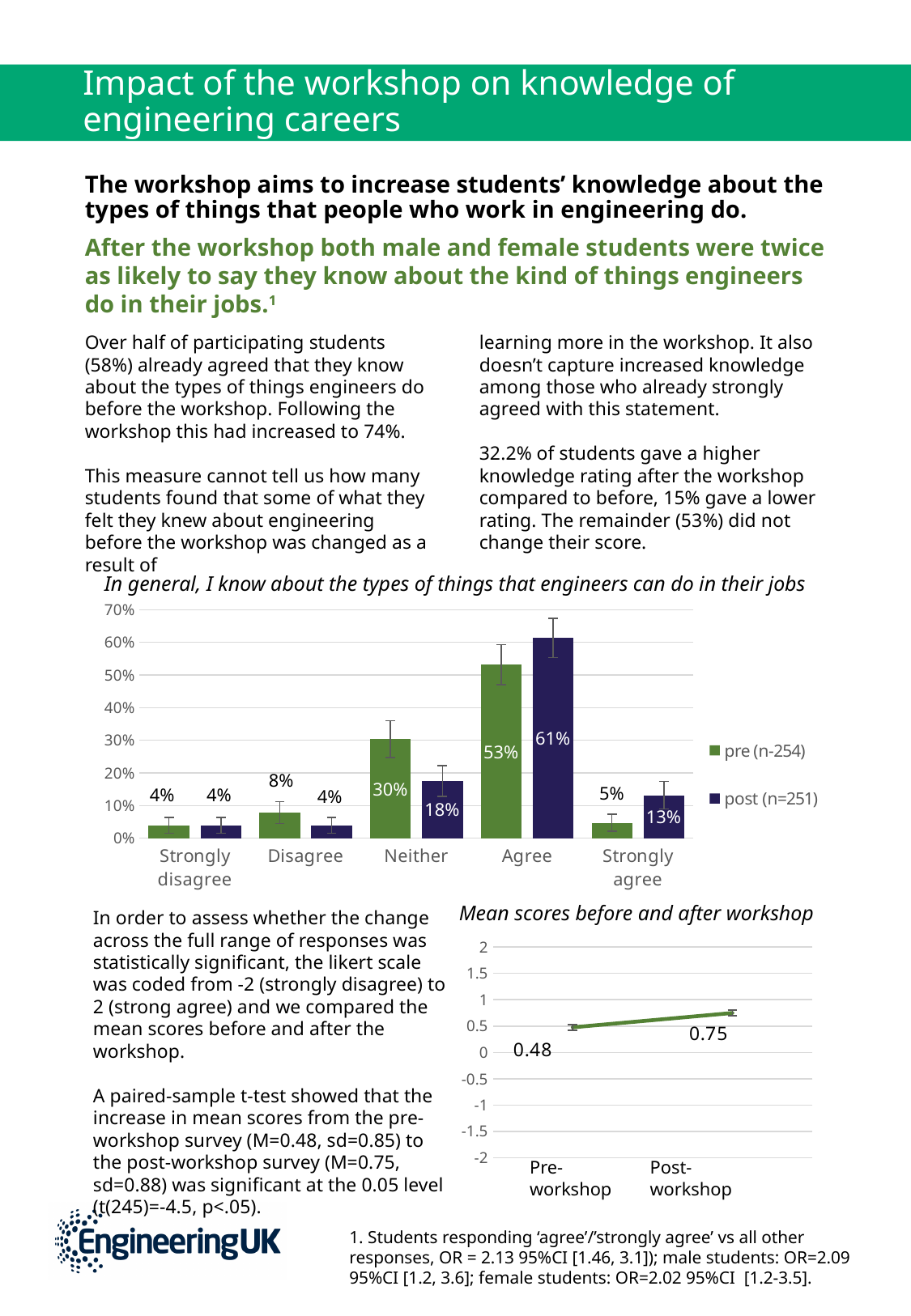
In the chart 'Mean scores before and after workshop', do the values rise or fall from Pre-workshop to Post-workshop? rise In the chart 'In general, I know about the types of things that engineers can do in their jobs', which category has the highest post-workshop value? Agree In the chart 'In general, I know about the types of things that engineers can do in their jobs', how many series does the legend list? 2 In the chart 'In general, I know about the types of things that engineers can do in their jobs', what is the difference between the post and pre values for Agree? 8% In the chart 'In general, I know about the types of things that engineers can do in their jobs', what is the pre-workshop value for Agree? 53% In the chart 'Mean scores before and after workshop', what is the difference between the Post-workshop and Pre-workshop mean scores? 0.27 In the chart 'In general, I know about the types of things that engineers can do in their jobs', which is larger for Neither: the pre value or the post value? pre In the chart 'In general, I know about the types of things that engineers can do in their jobs', how many response categories are shown on the x axis? 5 In the chart 'Mean scores before and after workshop', what is the mean score for Post-workshop? 0.75 In the chart 'In general, I know about the types of things that engineers can do in their jobs', what is the post-workshop value for Strongly agree? 13% In the chart 'In general, I know about the types of things that engineers can do in their jobs', what is the post-workshop value for Neither? 18% What kind of chart is 'In general, I know about the types of things that engineers can do in their jobs'? bar chart